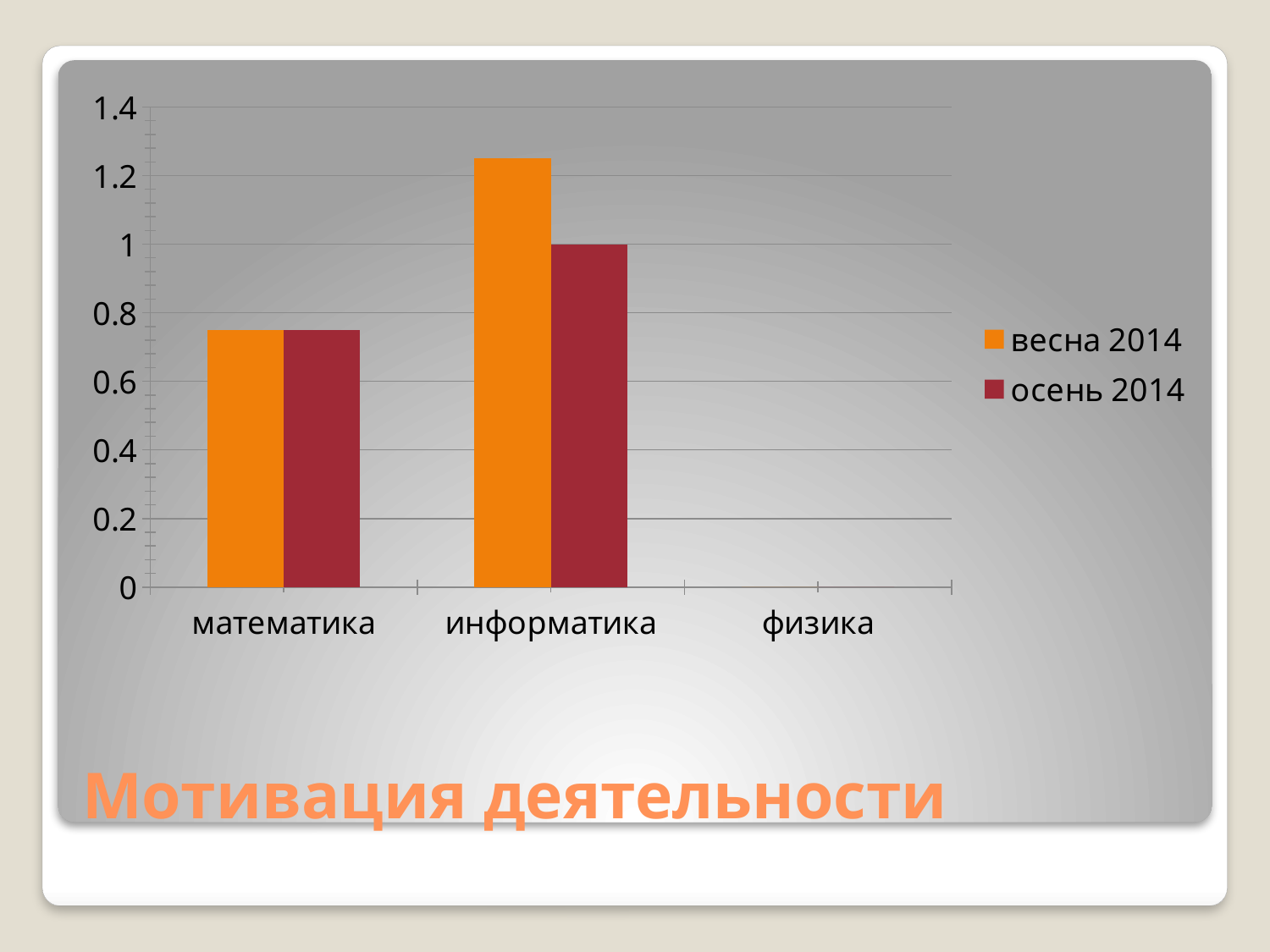
Is the value for весна 2014 in математика greater or less than 0.8? less Which category has the highest value for осень 2014? информатика What is the title of the chart? Мотивация деятельности Which category has the highest value for весна 2014? информатика Is the value for осень 2014 in математика greater or less than 0.6? greater For информатика, which series has the larger value, весна 2014 or осень 2014? весна 2014 How many categories are shown on the x axis? 3 How many series does the legend list? 2 Which series is shown in orange? весна 2014 Is the value for весна 2014 in информатика greater or less than 1.2? greater What kind of chart is shown on the slide? bar chart What is the value for осень 2014 in информатика? 1